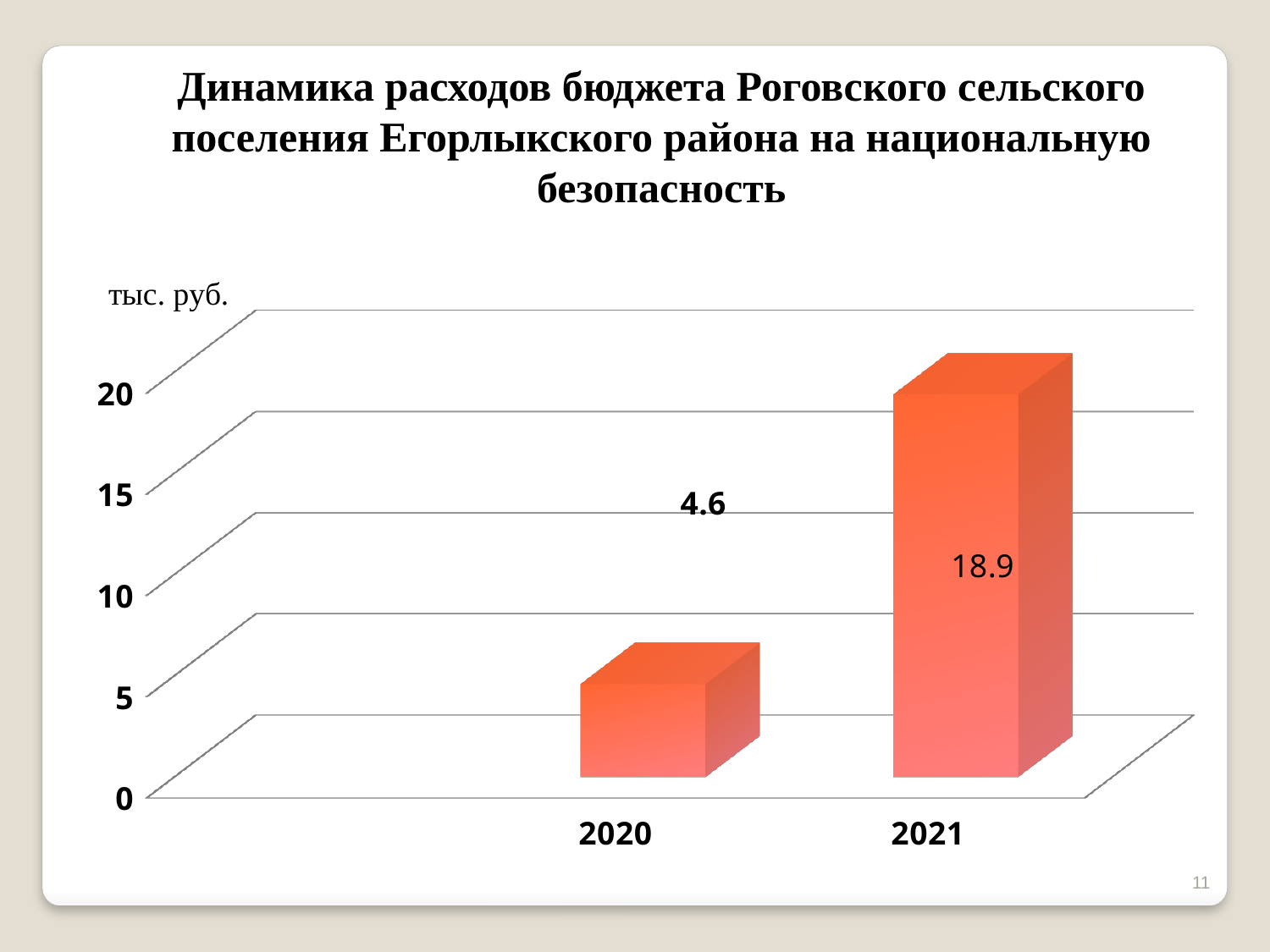
Is the value for 2021 greater or less than 15? greater What unit is indicated for the values on the chart? тыс. руб. How many years are shown on the x axis? 2 Which year has the lowest value? 2020 Which is larger, the value for 2020 or the value for 2021? 2021 What is the value for 2021? 18.9 Is the value for 2020 greater or less than 10? less What is the difference between the values for 2021 and 2020? 14.3 What is the value for 2020? 4.6 Do the values rise or fall from 2020 to 2021? rise What kind of chart is shown on the slide? bar chart Which year has the highest value? 2021